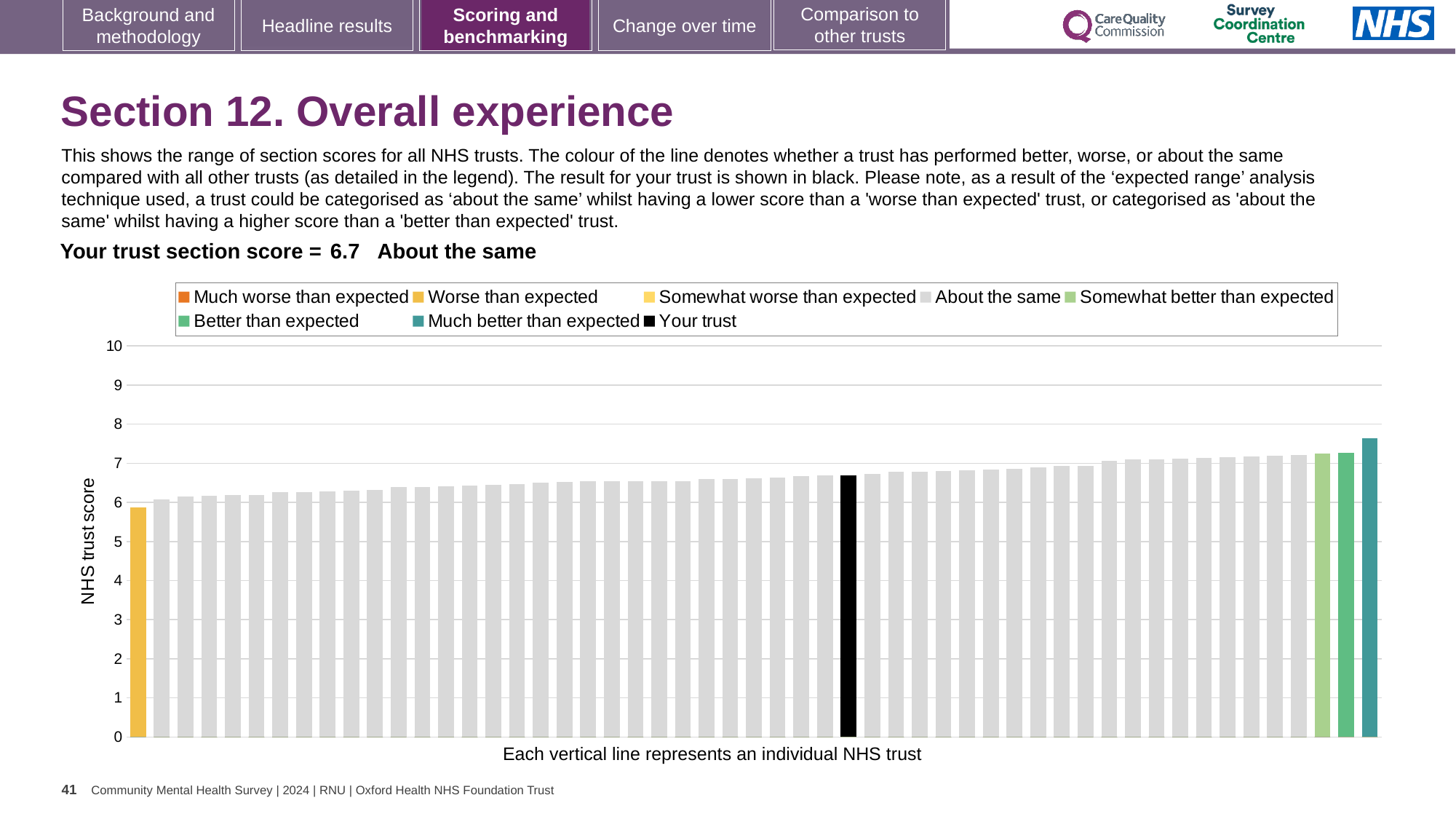
Which legend category does the highest bar on the chart belong to? Much better than expected How is your trust's section score categorised compared with other trusts? About the same Which is larger, the rightmost bar or the leftmost bar? the rightmost bar Is the value of the black bar (your trust) greater or less than 6? greater How many entries does the chart legend list? 8 Do the bar values rise or fall from left to right along the x axis? rise What is the section score for your trust shown on the slide? 6.7 What kind of chart is shown on the slide? bar chart What is the label on the vertical axis of the chart? NHS trust score Is the value of the rightmost bar greater or less than 7? greater Is the value of the black bar (your trust) greater or less than 7? less